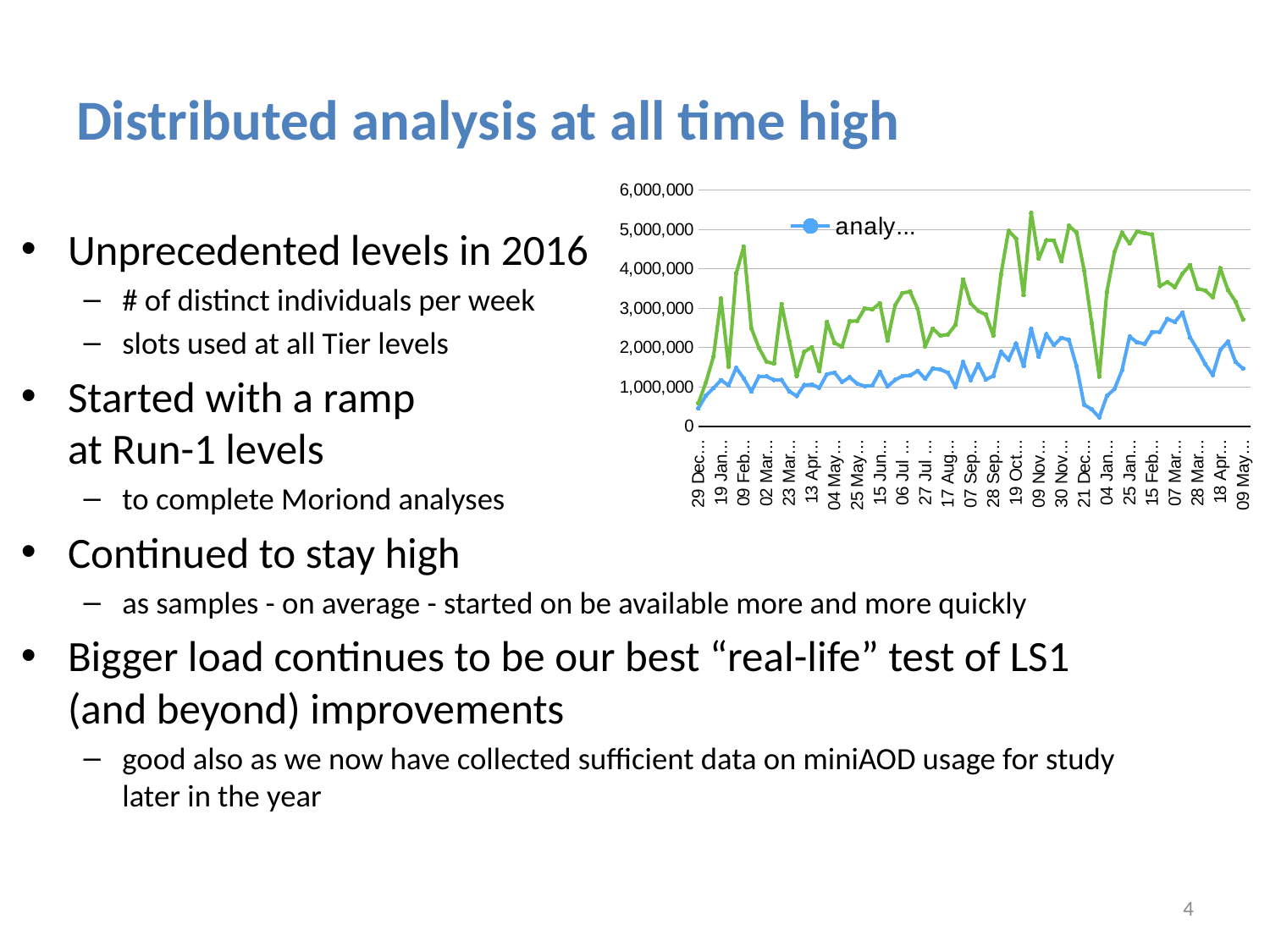
How many series does the chart's legend list? 1 What is the label of the series shown in the chart's legend? analy... Is the value of the green line at 09 May greater or less than 2,000,000? greater Which line reaches higher values overall, the green line or the blue line? green Is the peak value of the green line greater or less than 5,000,000? greater What kind of chart is shown on the slide? line chart What is the highest value shown on the chart's vertical axis? 6,000,000 Overall, does the green line rise or fall from 29 Dec to 09 May? rise How many date labels are shown along the chart's x axis? 25 Is the value of the blue line at 29 Dec greater or less than 1,000,000? less